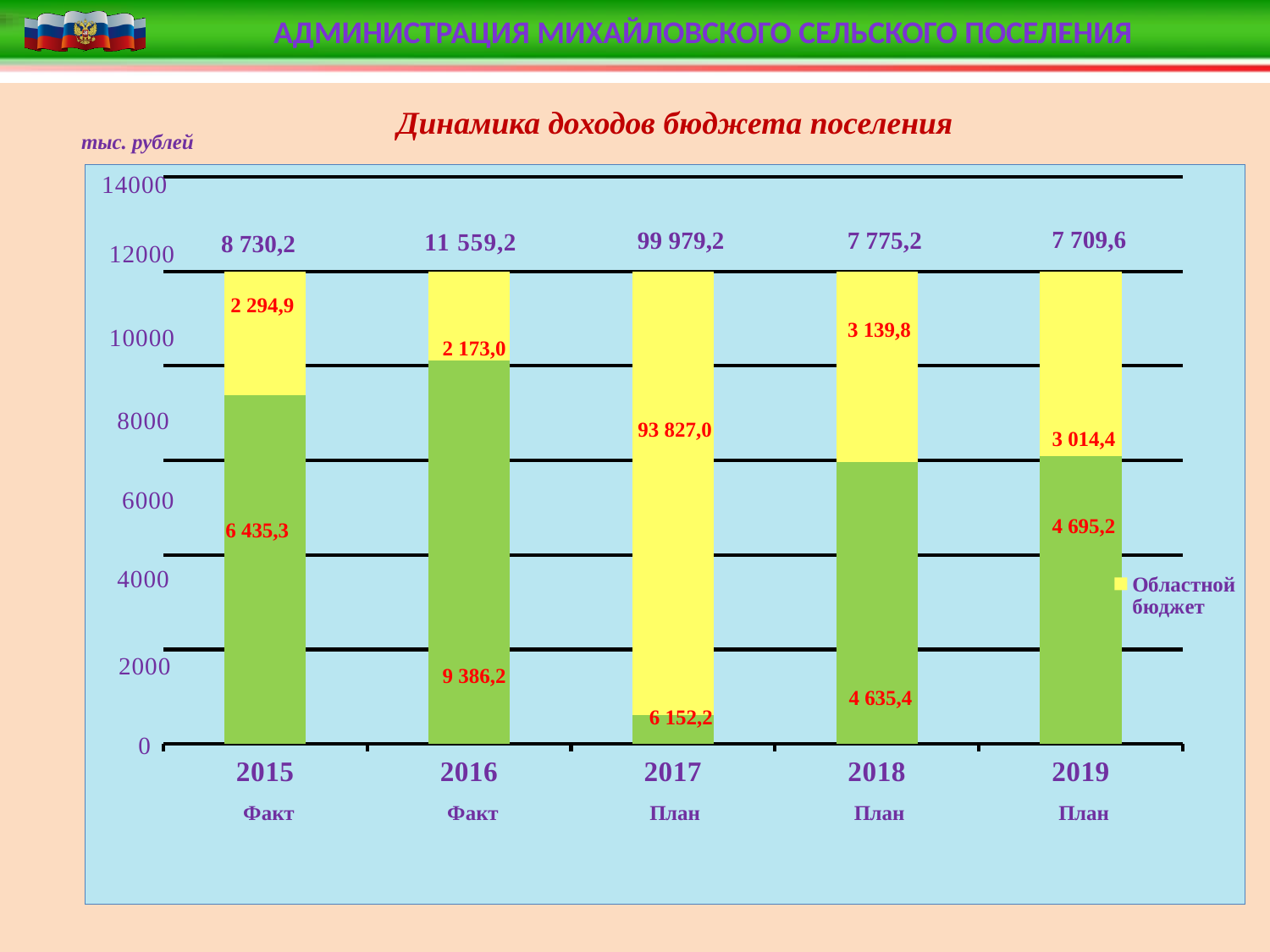
What is the value of Областной бюджет for 2018? 3 139,8 What is the value of Областной бюджет for 2015? 2 294,9 What is the title of the chart? Динамика доходов бюджета поселения What kind of chart is shown on the slide? stacked bar chart What is the difference between the total printed above the 2015 bar and the total printed above the 2018 bar? 955,0 What value is printed on the green segment of the 2017 bar? 6 152,2 Which year has the lowest value of Областной бюджет? 2016 What total value is printed above the bar for 2016? 11 559,2 Which year has the highest value of Областной бюджет? 2017 What total value is printed above the bar for 2019? 7 709,6 Which year has the larger value of Областной бюджет, 2018 or 2019? 2018 How many years are shown along the x axis of the chart? 5